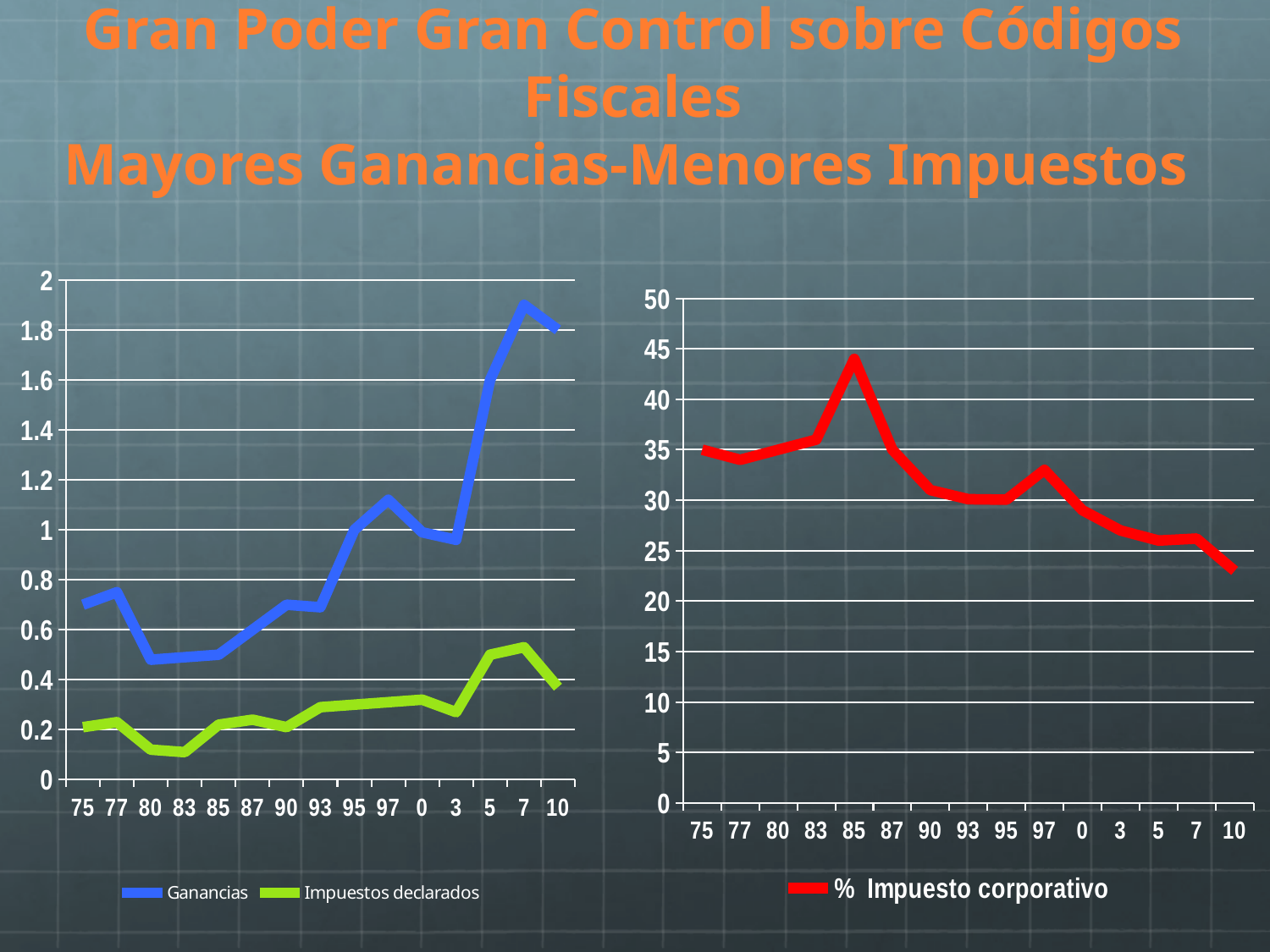
What series does the legend of the right chart list? % Impuesto corporativo In the right chart, does % Impuesto corporativo generally rise or fall from 75 to 10? fall In the right chart, is the value of % Impuesto corporativo at 85 greater or less than 40? greater In the left chart, is the value of Ganancias at 7 greater or less than 1.8? greater In the right chart, at which x-axis label is % Impuesto corporativo highest? 85 How many series does the legend of the left chart list? 2 In the left chart, is the value of Ganancias at 75 greater or less than 0.8? less In the left chart, at which x-axis label does Ganancias reach its highest value? 7 What type of chart is the chart on the left of the slide? line chart In the right chart, at which x-axis label is % Impuesto corporativo lowest? 10 How many points are plotted along the x axis of the right chart? 15